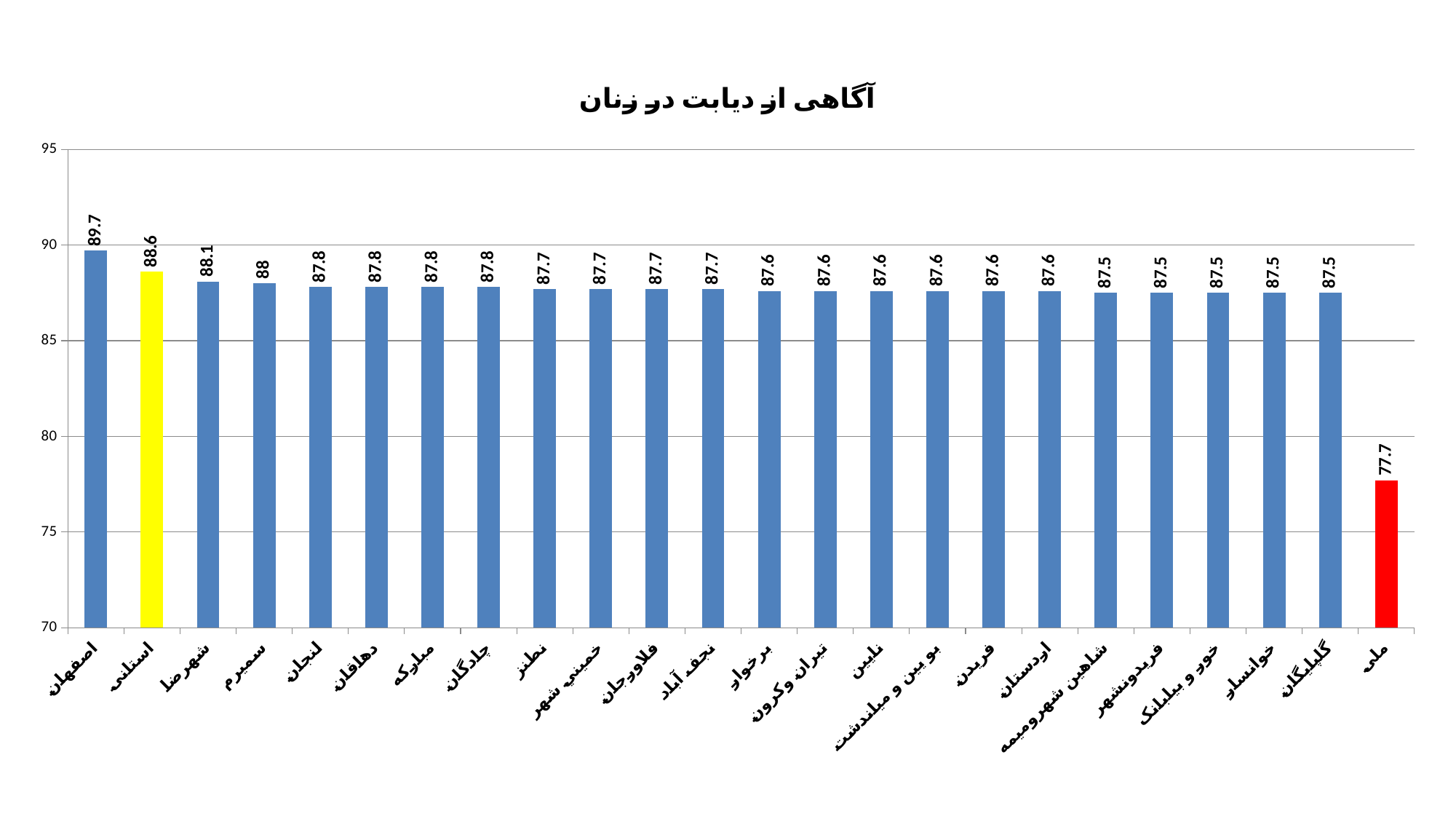
What is the value for اصفهان? 89.7 What is the value for ملی? 77.7 What is the value for سمیرم? 88 Which category has the lowest value? ملی What kind of chart is shown on the slide? bar chart Which category has the highest value? اصفهان What is the difference between the values for اصفهان and ملی? 12 How many bars are shown in the chart? 24 Which is larger, the value for اصفهان or the value for استانی? اصفهان Is the value for ملی greater or less than 80? less What is the value for استانی? 88.6 What is the difference between the values for استانی and شهرضا? 0.5